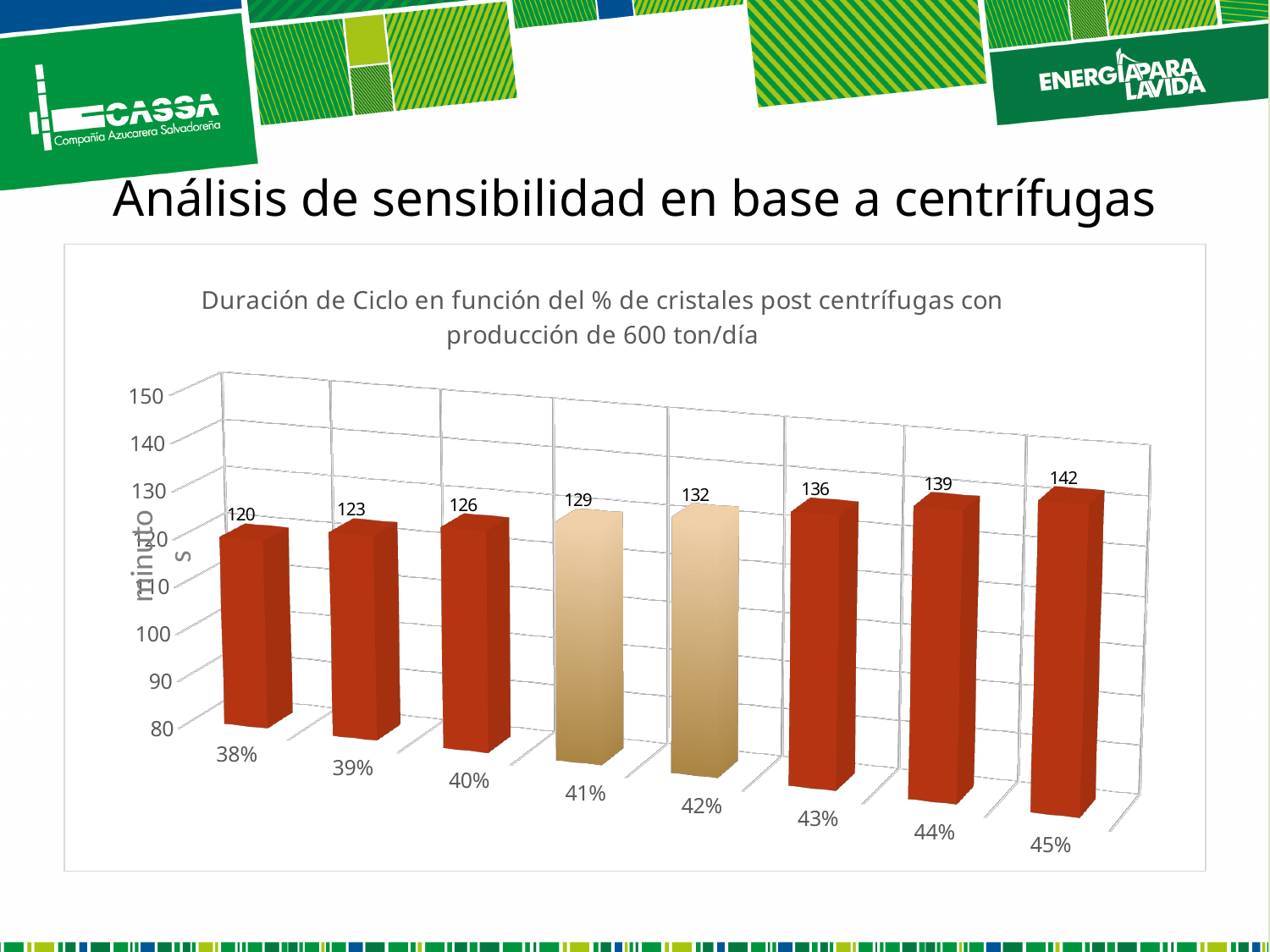
Which category has the lowest value? 38% What is the difference between the values for 45% and 38%? 22 Which category has the highest value? 45% How many categories are shown on the x axis? 8 What is the value shown for the 45% category? 142 What is the cycle duration value for 38%? 120 What is the value shown for the 42% category? 132 Do the values rise or fall as the percentage of crystals increases along the x axis? rise What kind of chart is this? bar chart What is the difference between the values for 43% and 41%? 7 Which two categories are shown with a different (tan) bar colour from the rest? 41% and 42% Which has a larger value, 40% or 44%? 44%